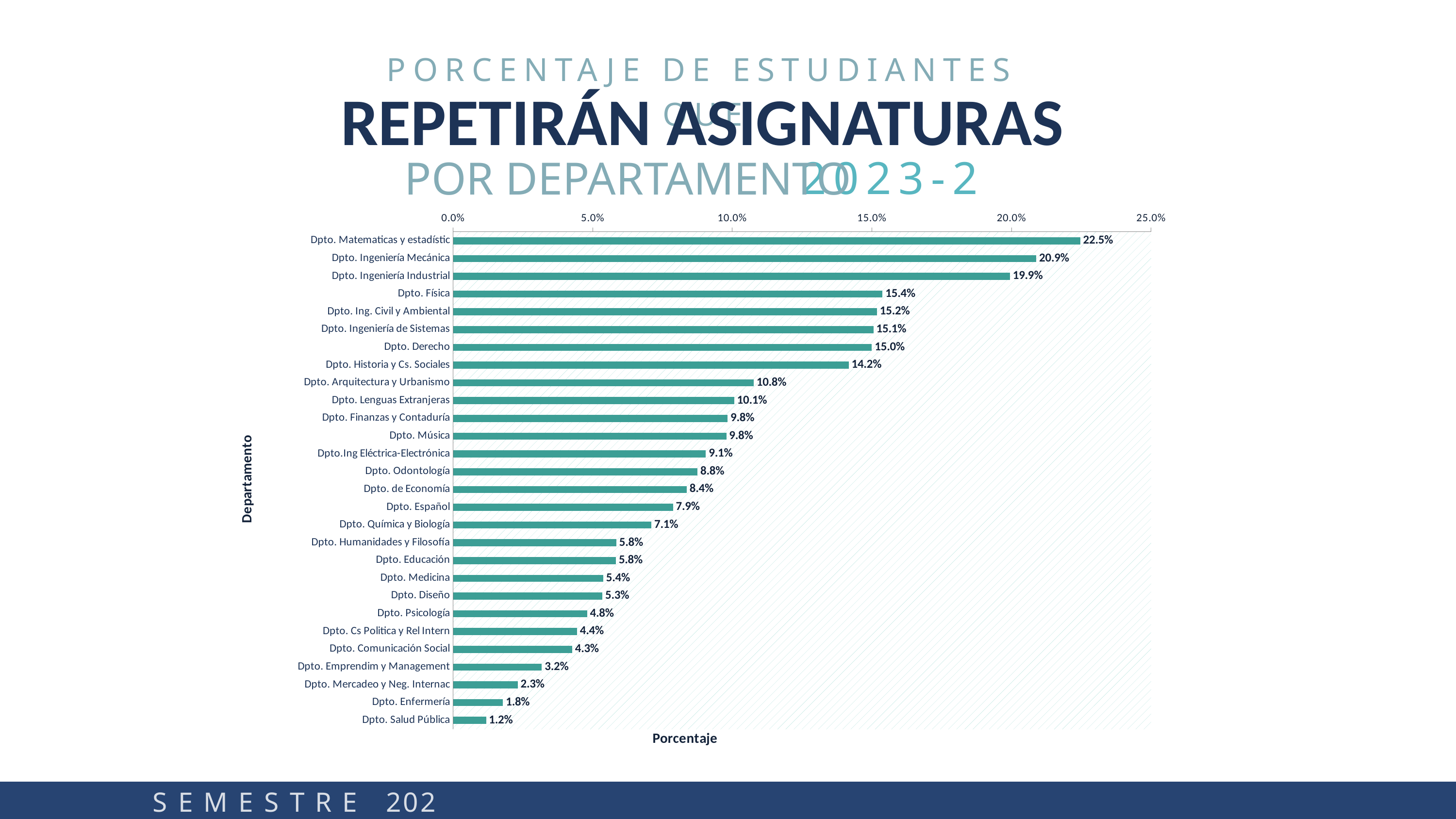
Which department has the lowest percentage? Dpto. Salud Pública Which is larger, the value for Dpto. Arquitectura y Urbanismo or the value for Dpto. Lenguas Extranjeras? Dpto. Arquitectura y Urbanismo What is the value for Dpto. Psicología? 4.8% What is the difference between the values for Dpto. Ingeniería Industrial and Dpto. Física? 4.5% Is the value for Dpto. Historia y Cs. Sociales greater or less than 15.0%? less How many departments are shown in the chart? 28 Which department has the highest percentage? Dpto. Matematicas y estadístic What is the difference between the values for Dpto. Enfermería and Dpto. Salud Pública? 0.6% What is the value for Dpto. Derecho? 15.0% What is the label of the horizontal axis? Porcentaje What kind of chart is shown on the slide? bar chart What is the value for Dpto. Ingeniería Mecánica? 20.9%